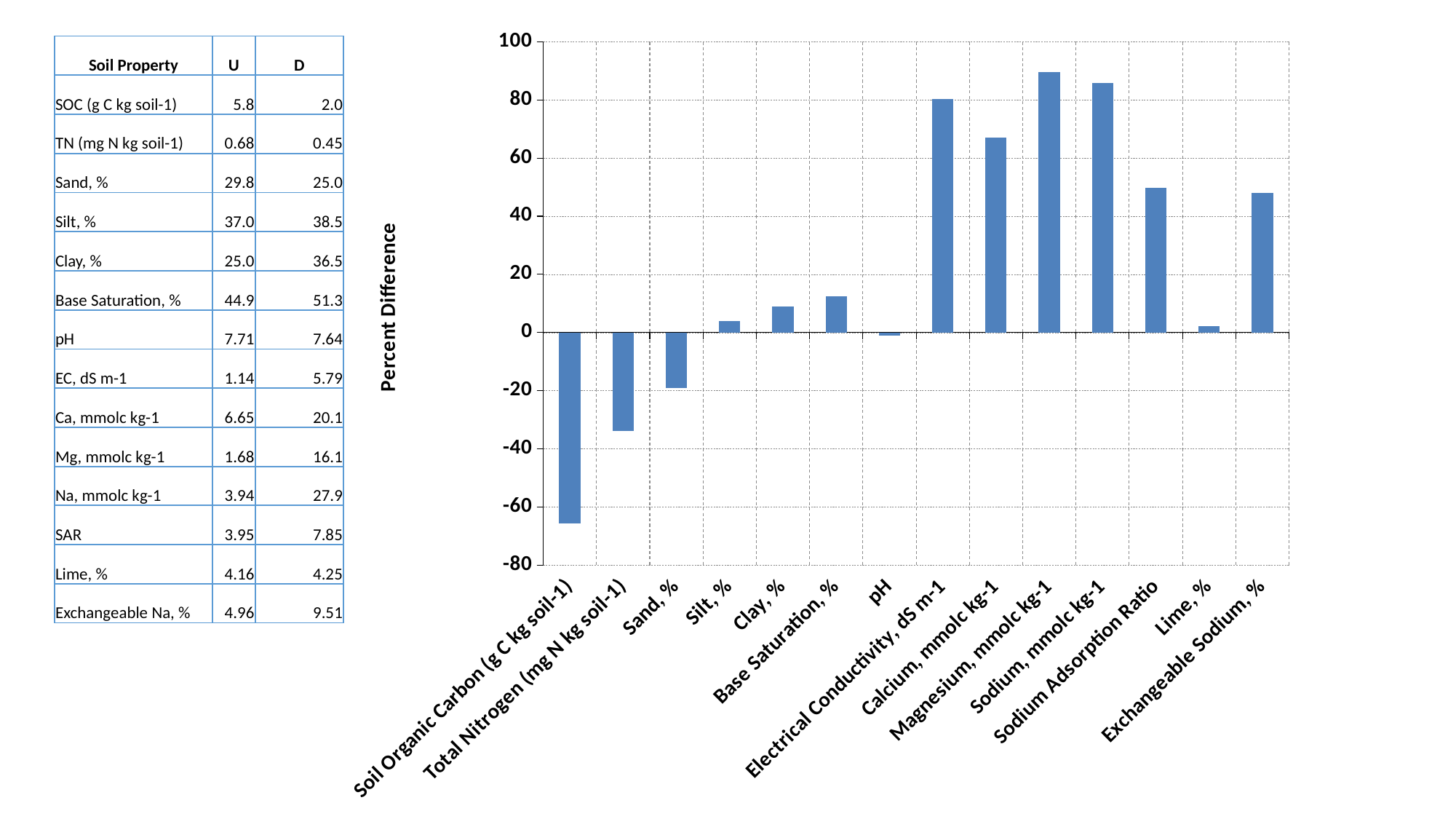
Is the percent difference for Exchangeable Sodium, % greater or less than 40? greater What is the title of the vertical axis of the chart? Percent Difference Is the percent difference for Lime, % greater or less than 20? less What kind of chart is shown on the slide? bar chart Which has the larger percent difference, Calcium, mmolc kg-1 or Sodium Adsorption Ratio? Calcium, mmolc kg-1 Which category has the lowest (most negative) percent difference? Soil Organic Carbon (g C kg soil-1) Is the percent difference for Calcium, mmolc kg-1 greater or less than 60? greater Which has the larger percent difference, Silt, % or Clay, %? Clay, % How many bars on the chart extend below zero? 4 How many soil properties (categories) are plotted on the chart? 14